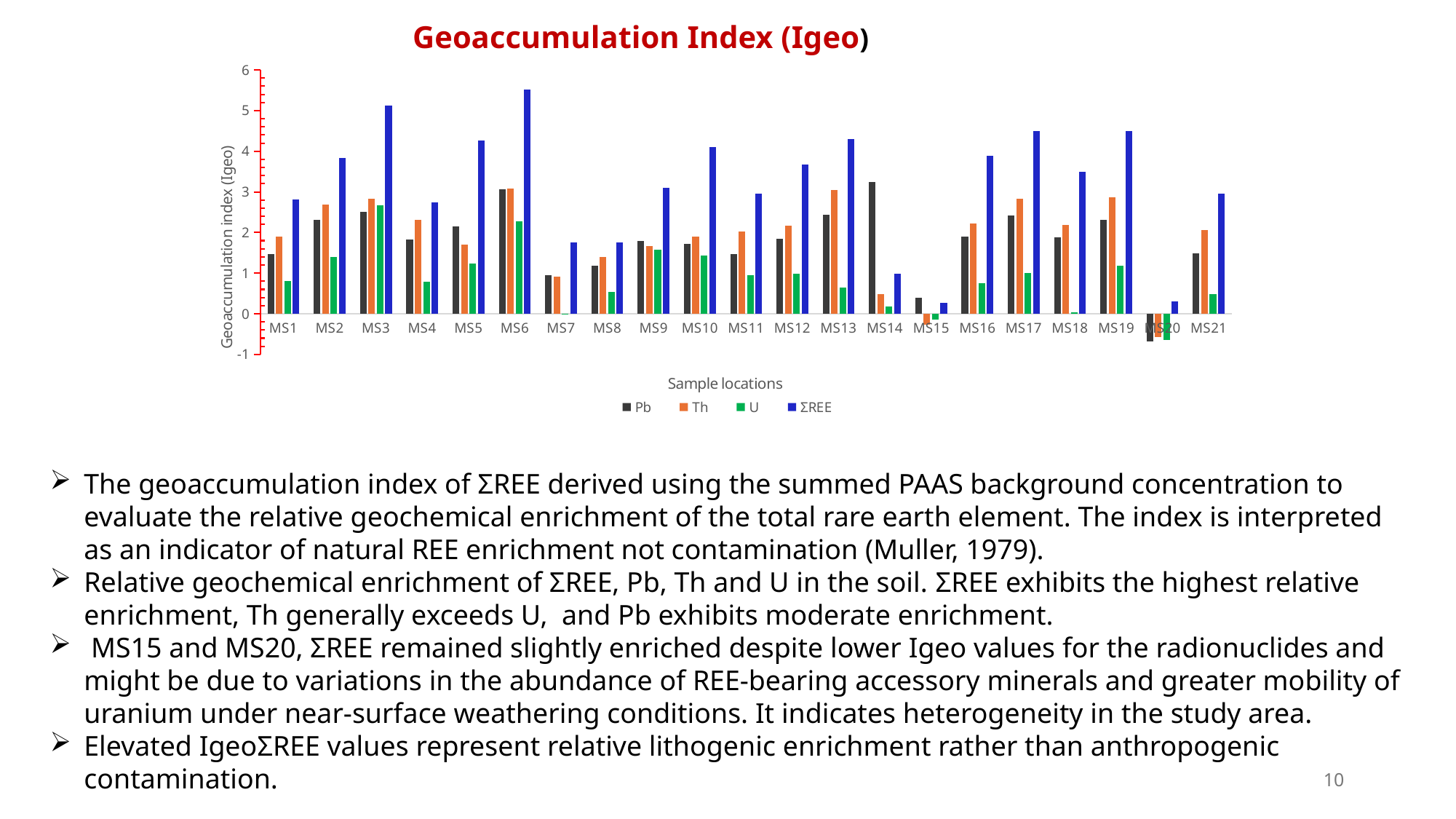
Is the ΣREE value for MS6 greater or less than 5? greater How many sample locations are shown on the x axis of the chart? 21 Is the Pb value for MS14 greater or less than 3? greater Which sample location has the lowest Pb value? MS20 What kind of chart is shown on the slide? bar chart Which sample location has the highest ΣREE value? MS6 What is the title of the chart's x axis? Sample locations Is the ΣREE value for MS7 greater or less than 2? less How many series does the chart's legend list? 4 Which is larger, the ΣREE value for MS6 or for MS3? MS6 Which sample location has the highest U value? MS3 Which is larger at MS14, the Pb value or the Th value? Pb